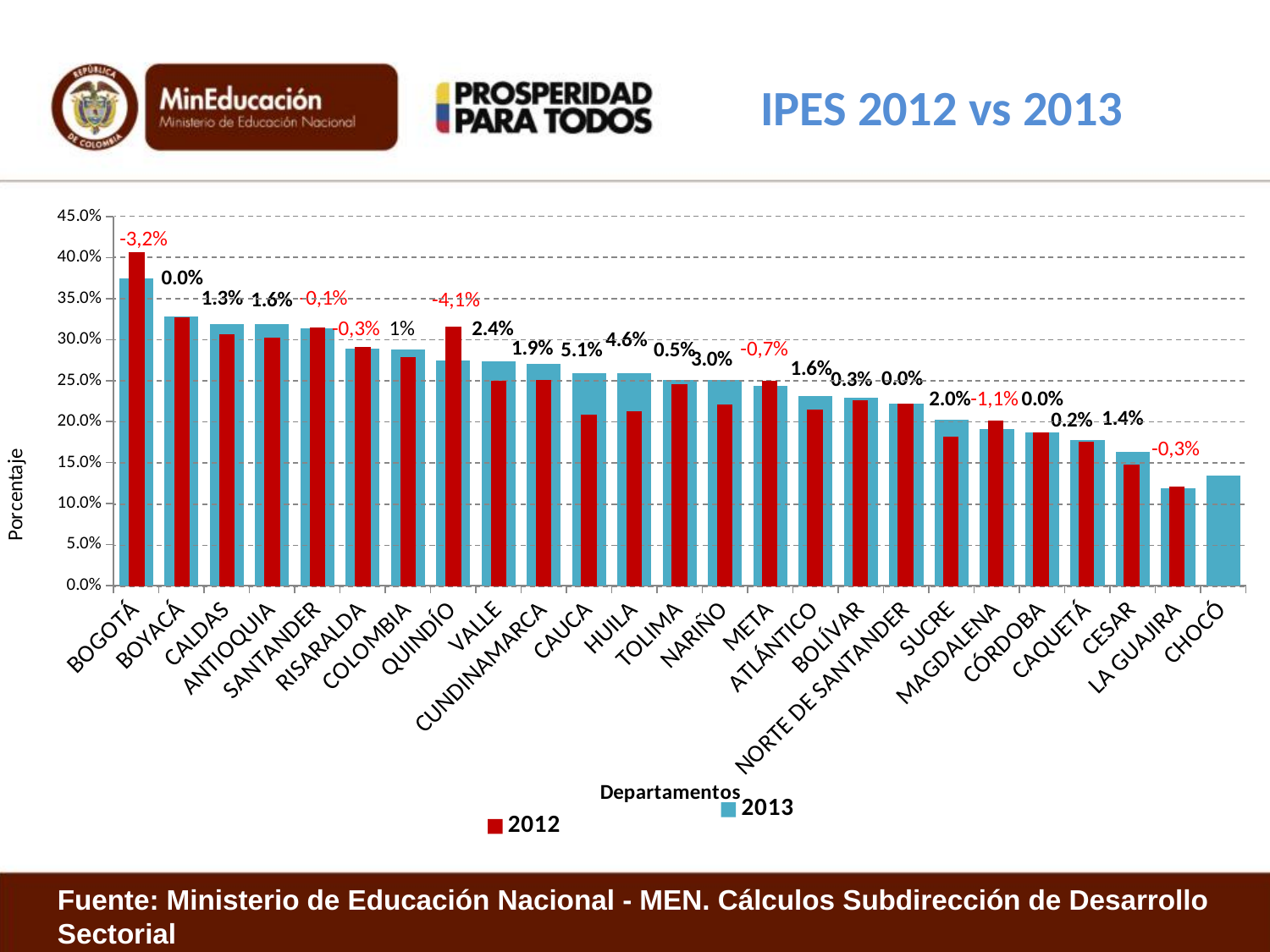
What value is labelled above the bars for BOGOTÁ? -3,2% Is the 2013 value for BOGOTÁ greater or less than 35.0%? greater How many series does the legend list? 2 What is the title of the chart? IPES 2012 vs 2013 What kind of chart is shown on the slide? Bar chart Which department has the highest 2012 value? BOGOTÁ Which department has the lowest 2013 value? LA GUAJIRA What is the label on the vertical axis? Porcentaje What value is labelled above the bars for QUINDÍO? -4,1% For CAUCA, which is larger, the 2012 value or the 2013 value? 2013 How many departments (categories) are shown on the x axis? 25 What value is labelled above the bars for CAUCA? 5.1%